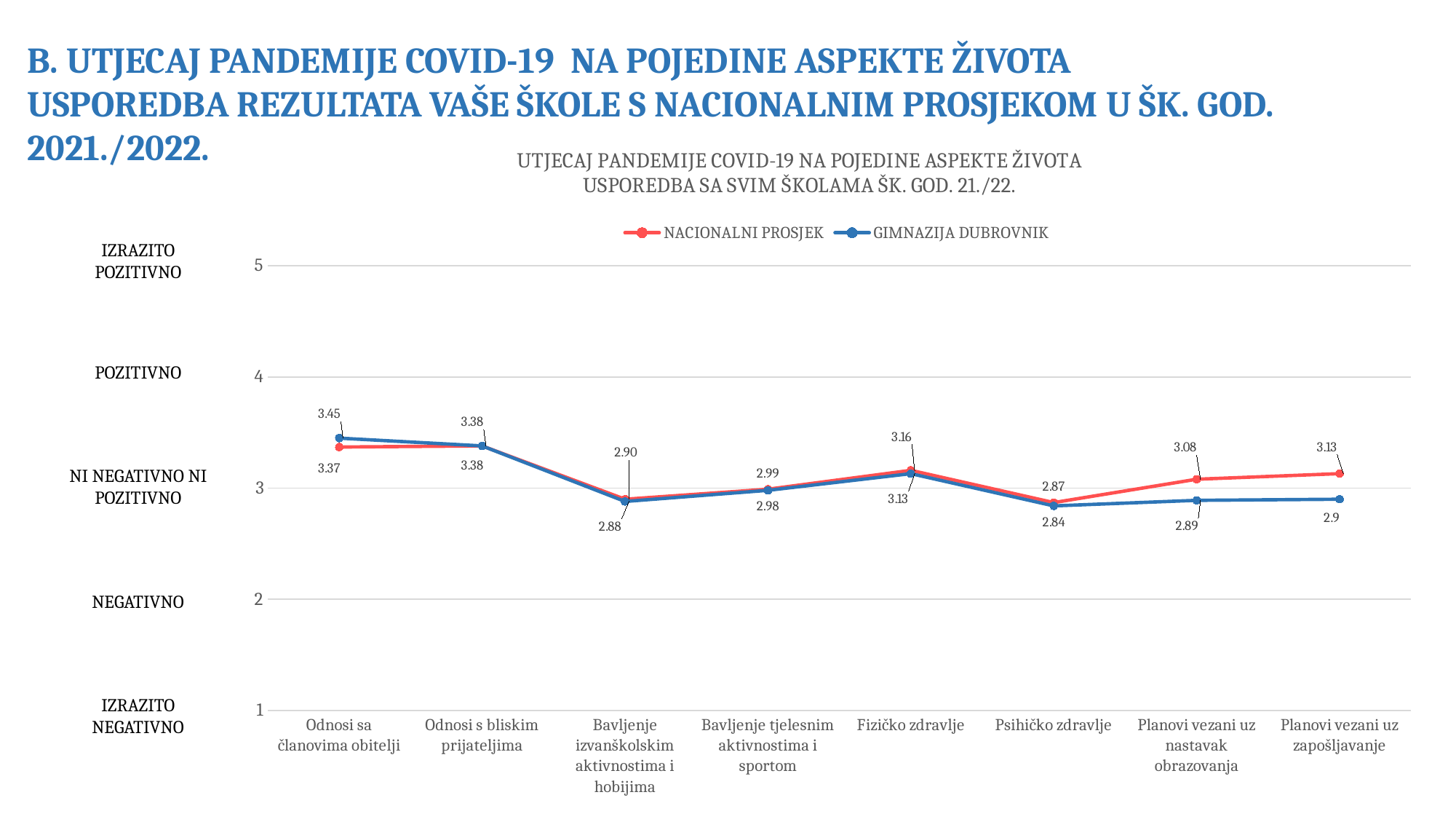
What is the difference between NACIONALNI PROSJEK and GIMNAZIJA DUBROVNIK for Planovi vezani uz nastavak obrazovanja? 0.19 Is the GIMNAZIJA DUBROVNIK value for Psihičko zdravlje greater or less than 3? less For which category is the GIMNAZIJA DUBROVNIK value lowest? Psihičko zdravlje How many series does the legend list? 2 What is the value for NACIONALNI PROSJEK for Fizičko zdravlje? 3.16 What is the value for GIMNAZIJA DUBROVNIK for Psihičko zdravlje? 2.84 For Planovi vezani uz zapošljavanje, which series has the larger value, NACIONALNI PROSJEK or GIMNAZIJA DUBROVNIK? NACIONALNI PROSJEK What is the value for GIMNAZIJA DUBROVNIK for Odnosi sa članovima obitelji? 3.45 How many categories are shown on the x axis? 8 For which category is the GIMNAZIJA DUBROVNIK value highest? Odnosi sa članovima obitelji What kind of chart is shown on the slide? line chart What is the value for NACIONALNI PROSJEK for Planovi vezani uz nastavak obrazovanja? 3.08